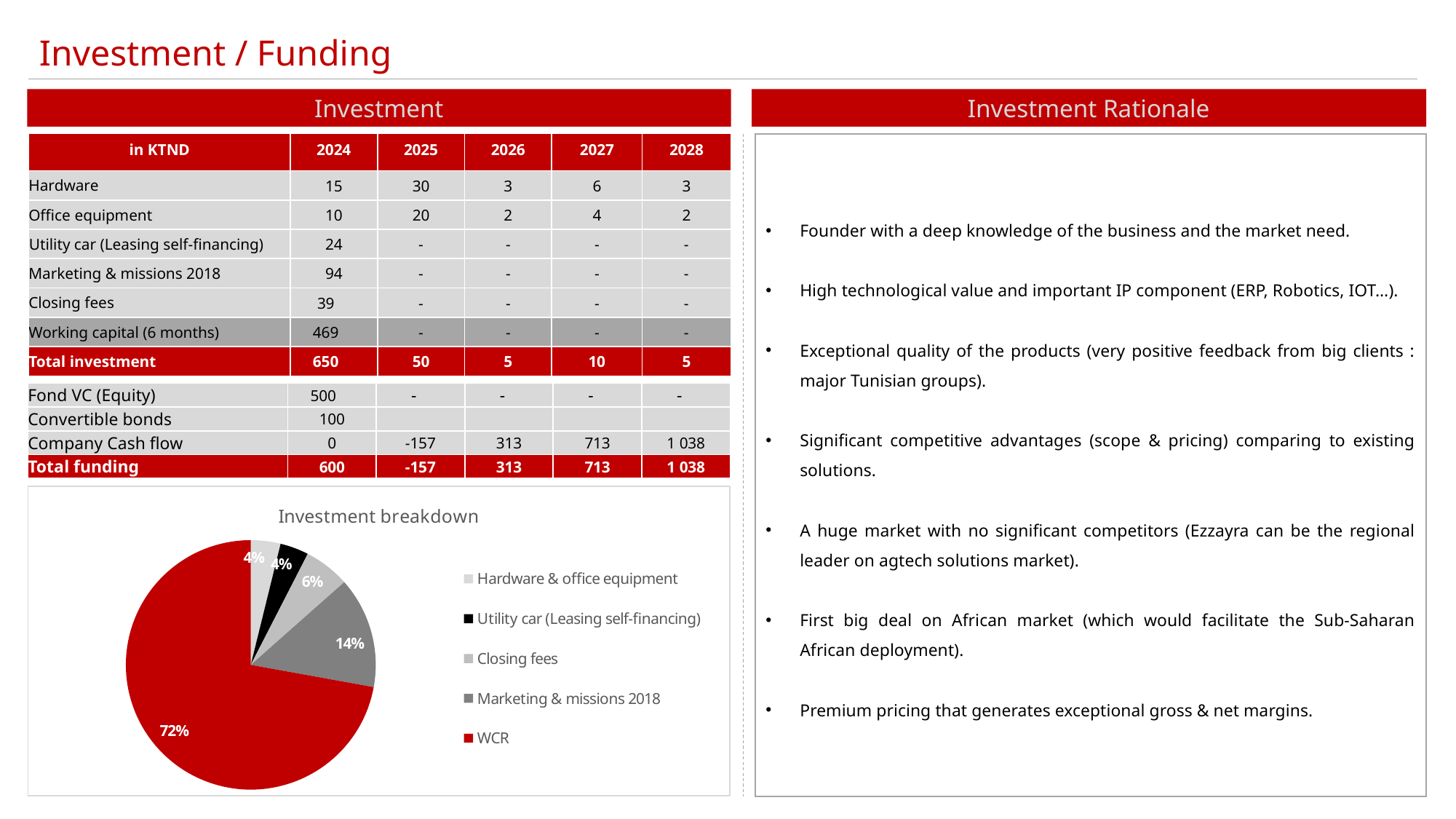
What is the title of the pie chart on the slide? Investment breakdown In the Investment breakdown chart, which is larger: Marketing & missions 2018 or Closing fees? Marketing & missions 2018 In the Investment breakdown chart, what share does WCR represent? 72% How many slices does the Investment breakdown pie chart have? 5 In the Investment breakdown chart, what is the difference between the WCR share and the Marketing & missions 2018 share? 58% Which category has the largest slice in the Investment breakdown chart? WCR In the Investment breakdown chart, what is the value for Closing fees? 6% What colour is the WCR slice in the Investment breakdown chart? red How many entries does the legend of the Investment breakdown chart list? 5 In the Investment breakdown chart, what is the value for Marketing & missions 2018? 14% In the Investment breakdown chart, what is the value for Utility car (Leasing self-financing)? 4% What kind of chart is the Investment breakdown chart? pie chart